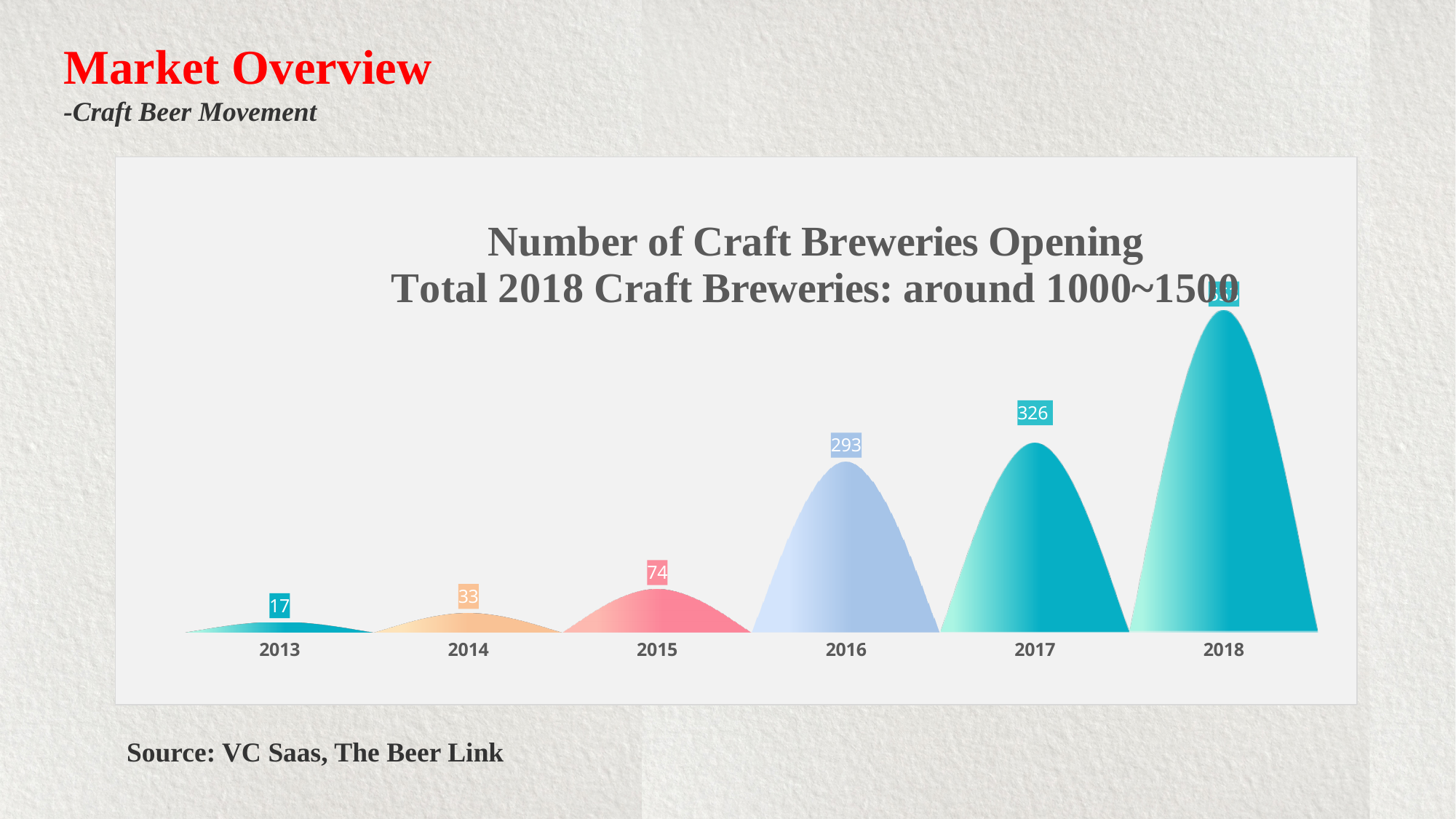
Which year had more craft breweries opening, 2014 or 2015? 2015 What is the number of craft breweries opening in 2015? 74 Do the values rise or fall from 2013 to 2018? rise What is the difference between the number of craft breweries opening in 2015 and in 2014? 41 What is the first line of the chart's title? Number of Craft Breweries Opening What is the number of craft breweries opening in 2016? 293 What is the number of craft breweries opening in 2013? 17 Which year has the highest number of craft breweries opening? 2018 What is the number of craft breweries opening in 2017? 326 Which year has the lowest number of craft breweries opening? 2013 What is the difference between the number of craft breweries opening in 2017 and in 2016? 33 How many years are shown on the x axis of the chart? 6